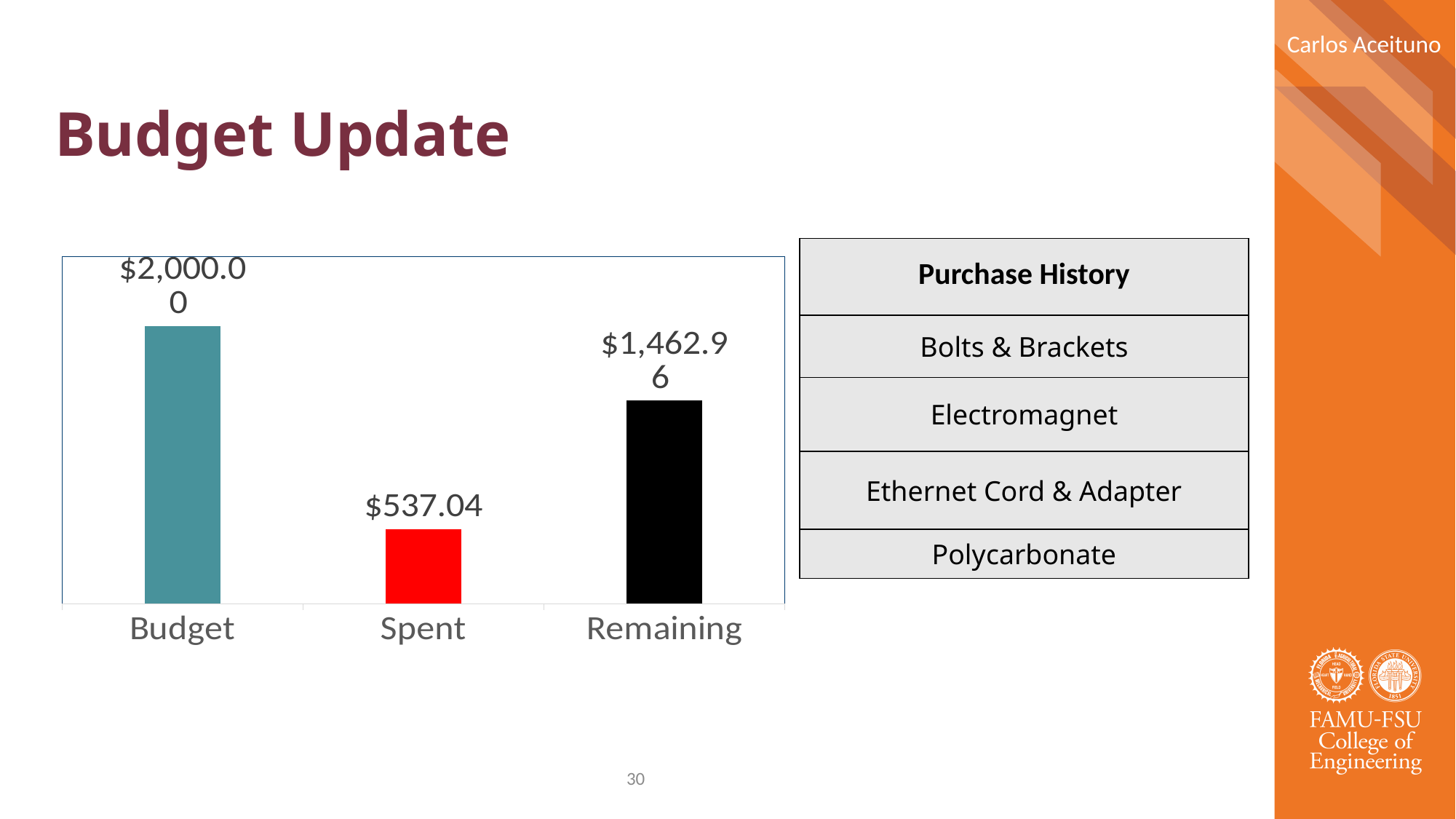
Which is larger, Spent or Remaining? Remaining What is the value of the Budget bar? $2,000.00 What is the value of the Remaining bar? $1,462.96 What is the difference between the Budget and Spent values? $1,462.96 What colour is the Spent bar? Red Which category has the lowest value? Spent What kind of chart is shown on the slide? Bar chart How many categories are shown in the chart? 3 Which category has the highest value? Budget What is the value of the Spent bar? $537.04 What is the difference between the Remaining and Spent values? $925.92 What colour is the Remaining bar? Black